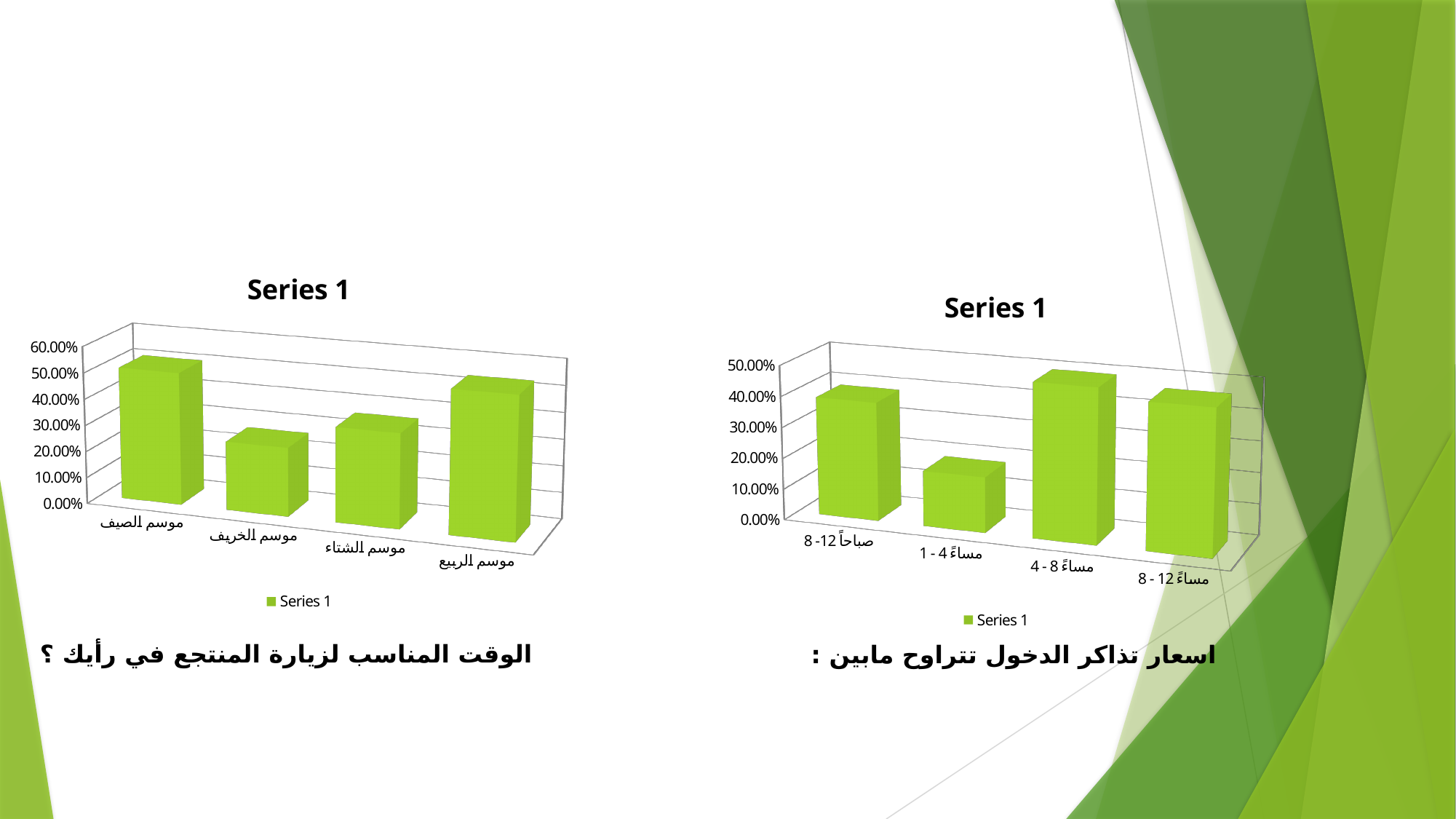
What kind of chart is the right chart on the slide? bar chart In the left chart, which is larger, the value for موسم الربيع or the value for موسم الخريف? موسم الربيع In the left chart, is the value for موسم الصيف greater or less than 40.00%? greater In the left chart, which category has the lowest value? موسم الخريف How many categories does the left chart show? 4 How many categories does the right chart show? 4 How many series does the legend of the right chart list? 1 What kind of chart is the left chart on the slide? bar chart In the left chart, which category has the highest value? موسم الربيع In the right chart, which category has the lowest value? 1 - 4 مساءً In the right chart, is the value for 1 - 4 مساءً greater or less than 20.00%? less In the left chart, is the value for موسم الخريف greater or less than 30.00%? less